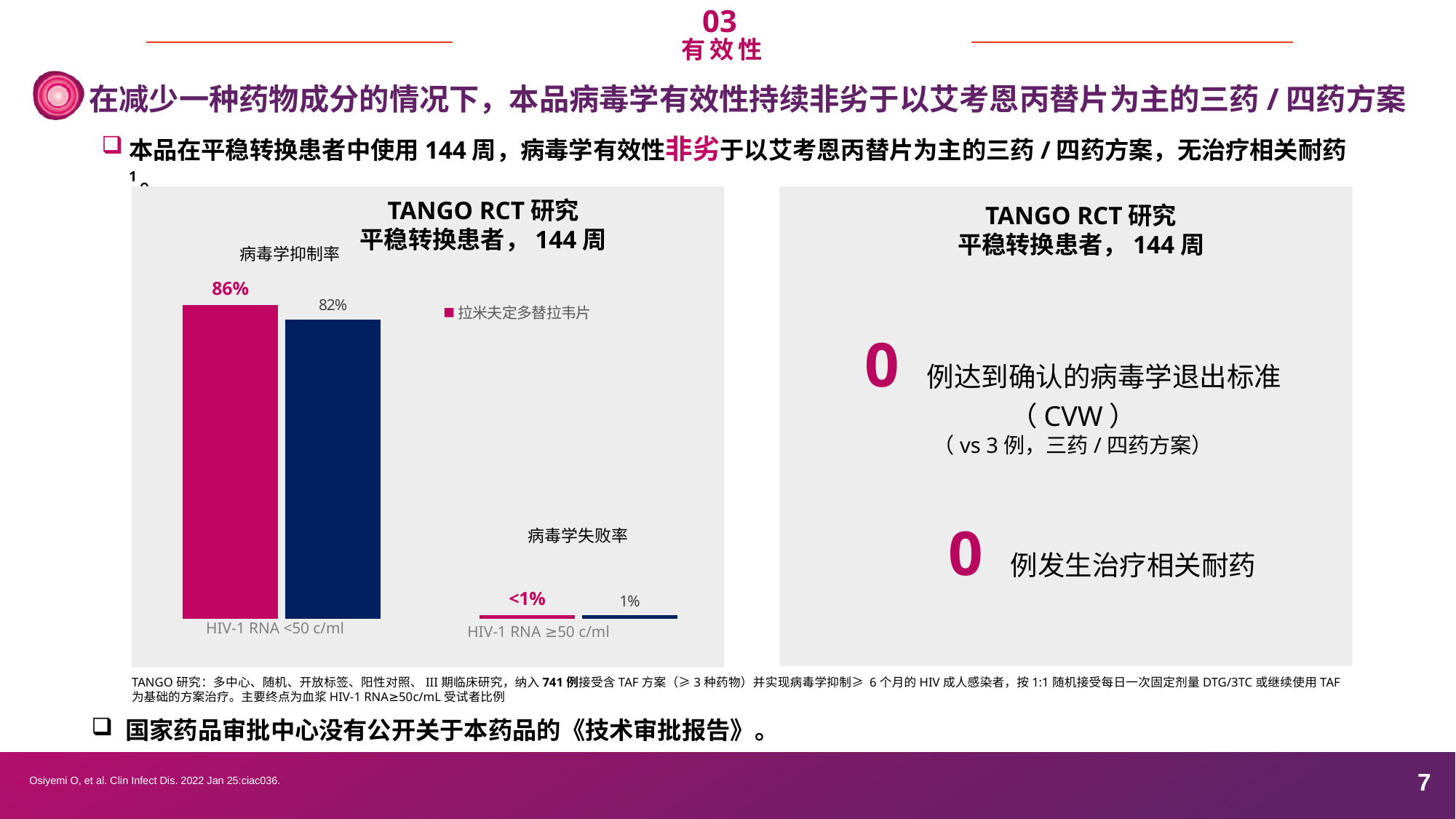
In the TANGO RCT bar chart, what is the lowest value shown? <1% In the TANGO RCT bar chart, what is the 病毒学失败率 (HIV-1 RNA ≥50 c/ml) for 拉米夫定多替拉韦片? <1% What kind of chart is shown on the left side of the slide? Bar chart What is the legend entry shown in the TANGO RCT bar chart? 拉米夫定多替拉韦片 In the TANGO RCT bar chart, what is the 病毒学抑制率 shown by the dark blue bar for HIV-1 RNA <50 c/ml? 82% In the TANGO RCT bar chart, which bar is higher for HIV-1 RNA <50 c/ml: the 拉米夫定多替拉韦片 bar or the dark blue bar? 拉米夫定多替拉韦片 How many categories are shown along the x axis of the TANGO RCT bar chart? 2 In the TANGO RCT bar chart, what is the 病毒学失败率 shown by the dark blue bar for HIV-1 RNA ≥50 c/ml? 1% In the TANGO RCT bar chart, what is the highest value shown? 86% In the TANGO RCT bar chart, what is the difference in 病毒学抑制率 between the 拉米夫定多替拉韦片 bar (86%) and the dark blue bar (82%)? 4 percentage points In the TANGO RCT bar chart, what is the 病毒学抑制率 (HIV-1 RNA <50 c/ml) for 拉米夫定多替拉韦片? 86% How many series does the legend of the TANGO RCT bar chart list? 1